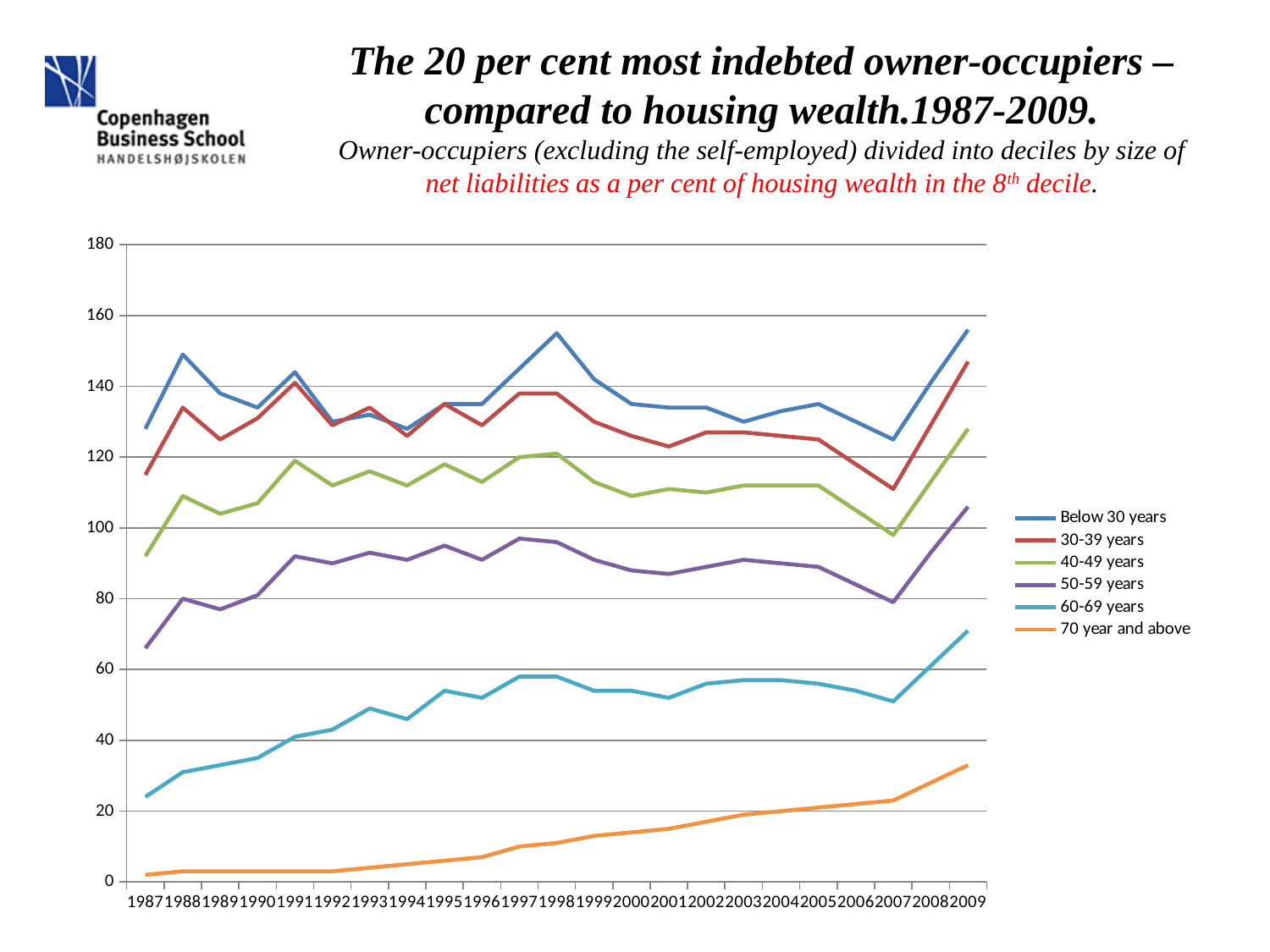
Does the 70 year and above series generally rise or fall from 1987 to 2009? rise How many years are plotted along the x axis? 23 Is the value for 40-49 years in 1987 greater or less than 100? less Which series has the highest value in 2009? Below 30 years Which series has the lowest value in 2009? 70 year and above How many series does the legend list? 6 Is the value for 60-69 years in 1987 greater or less than 40? less Is the value for Below 30 years in 1998 greater or less than 140? greater In 2009, which is larger: the value for Below 30 years or the value for 70 year and above? Below 30 years What is the first year shown on the x axis? 1987 What kind of chart is shown on the slide? line chart